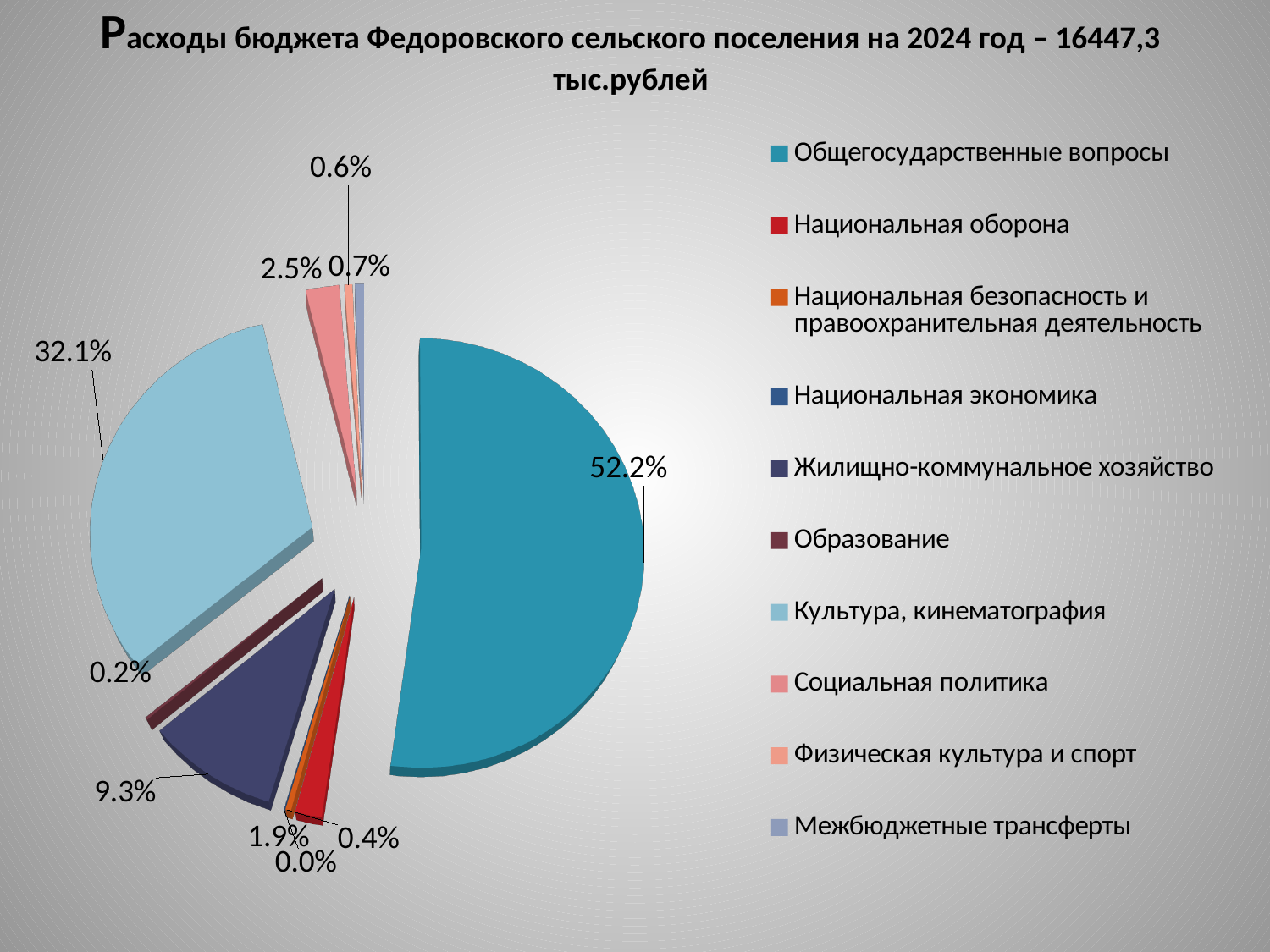
What share of the budget goes to Культура, кинематография? 32.1% Which category has the smallest share of the budget? Национальная экономика What share of the budget goes to Общегосударственные вопросы? 52.2% What is the difference in percentage points between Общегосударственные вопросы and Культура, кинематография? 20.1 What share of the budget goes to Национальная оборона? 1.9% Which category has the largest share of the budget? Общегосударственные вопросы What kind of chart is shown on the slide? pie chart What total budget amount is stated in the chart title? 16447,3 тыс.рублей How many categories does the legend list? 10 Which is larger: the share for Жилищно-коммунальное хозяйство or the share for Социальная политика? Жилищно-коммунальное хозяйство